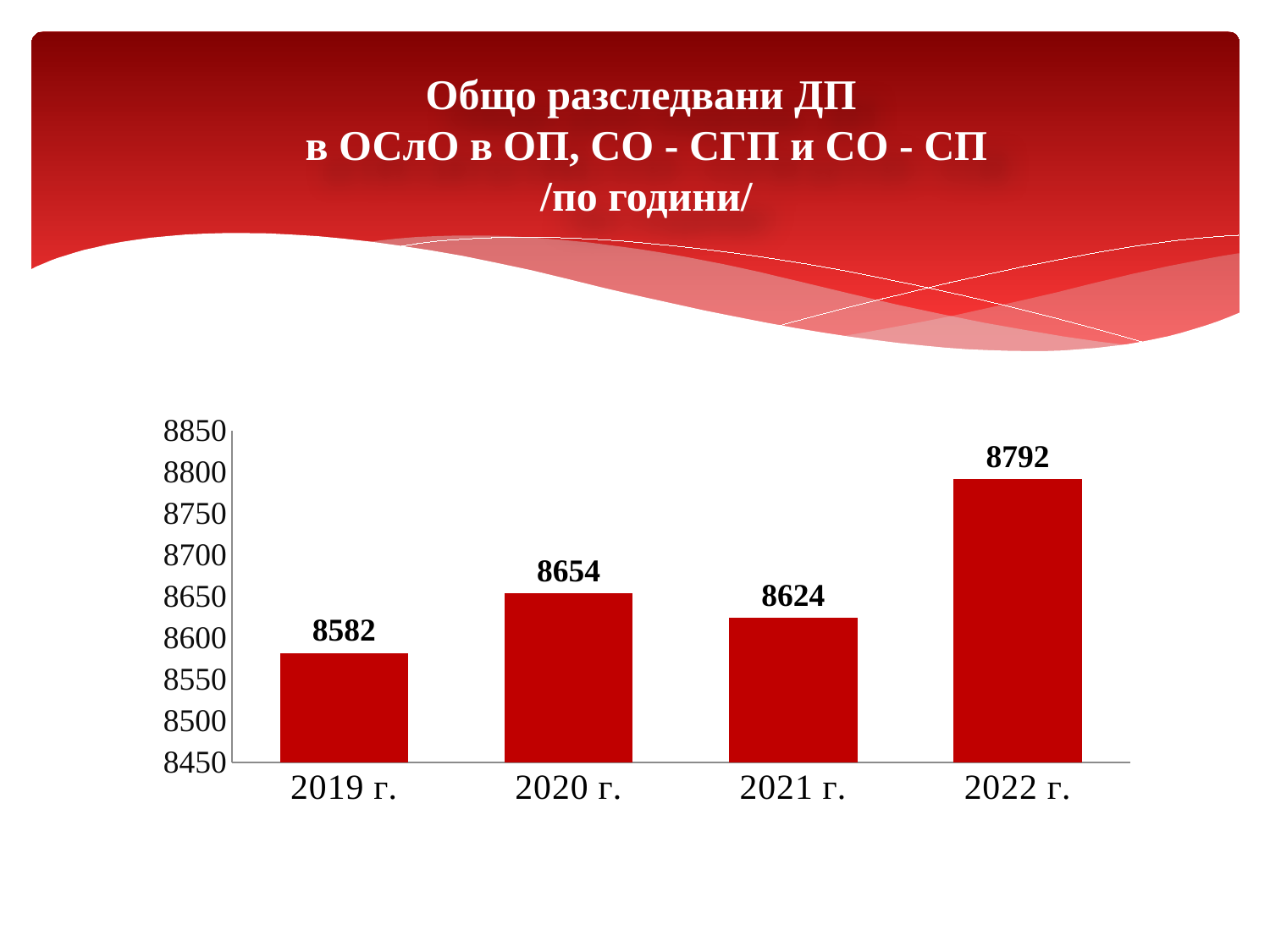
What kind of chart is shown on the slide? bar chart What is the difference between the values for 2020 г. and 2021 г.? 30 Which year has the highest value? 2022 г. What is the value for 2020 г.? 8654 Is the value for 2022 г. greater or less than 8750? greater What is the difference between the values for 2022 г. and 2019 г.? 210 Which is larger, the value for 2020 г. or the value for 2021 г.? 2020 г. How many years are shown on the x axis? 4 What is the value for 2021 г.? 8624 What is the value for 2022 г.? 8792 Which year has the lowest value? 2019 г. What is the value for 2019 г.? 8582